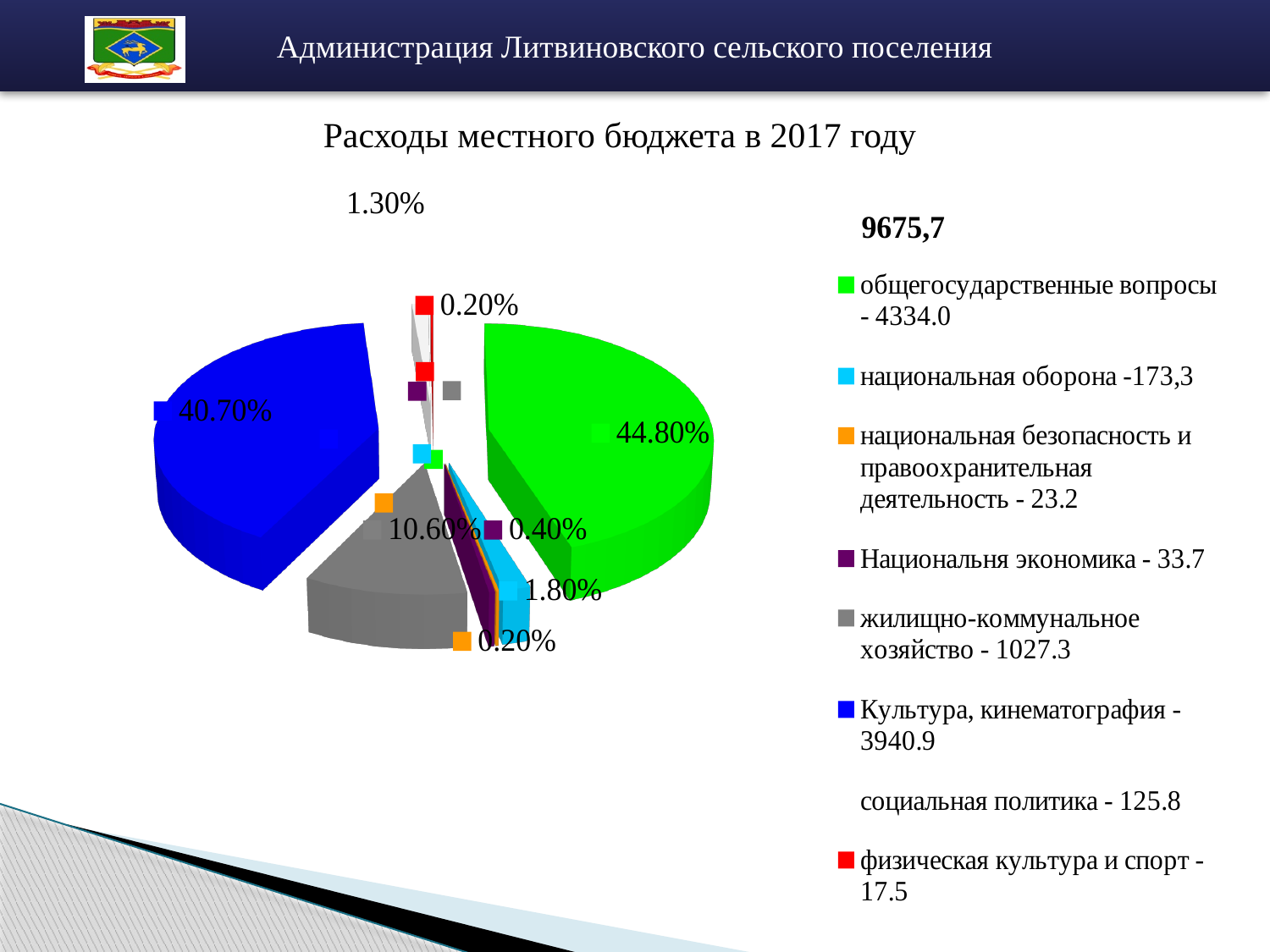
What share of the pie does "Культура, кинематография" take? 40.70% What total figure is printed above the legend? 9675,7 What share of the pie does "общегосударственные вопросы" take? 44.80% How many entries does the chart legend list? 8 Which slice is larger: "жилищно-коммунальное хозяйство" or "национальная оборона"? жилищно-коммунальное хозяйство What share of the pie does "национальная оборона" take? 1.80% What is the title of the chart? Расходы местного бюджета в 2017 году What is the difference in percentage points between the "общегосударственные вопросы" slice and the "Культура, кинематография" slice? 4.10% Which category has the largest slice of the pie? общегосударственные вопросы What type of chart is shown on the slide? pie chart What amount is shown in the legend for "Культура, кинематография"? 3940.9